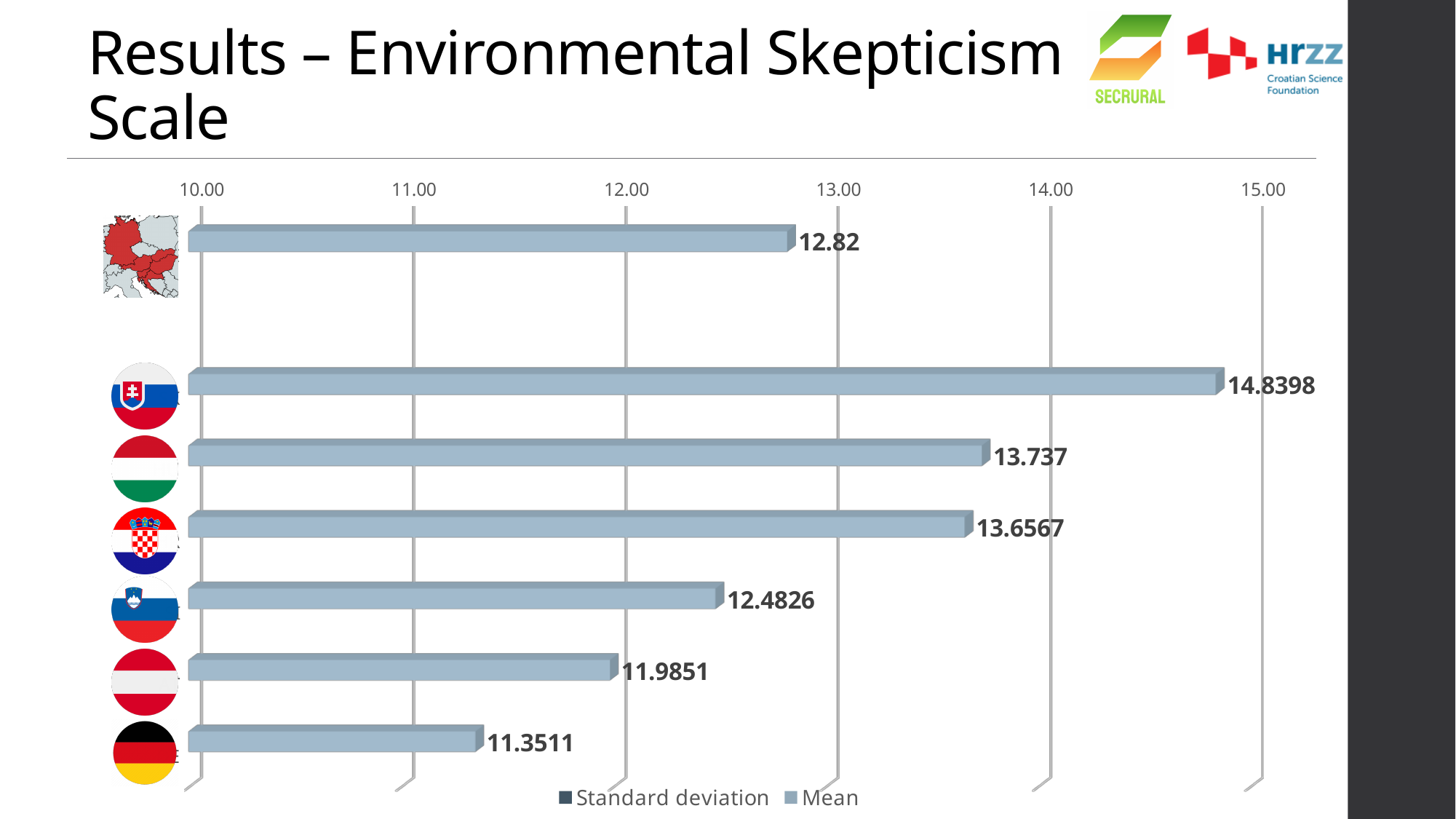
What is the value of the bar labelled with the Austrian flag? 11.9851 What is the value of the longest bar in the chart? 14.8398 What are the two series named in the legend? Standard deviation and Mean What is the difference between the longest bar (14.8398) and the shortest bar (11.3511)? 3.4887 Is the value of the topmost bar greater or less than 13.00? less How many series does the legend list? 2 What is the value of the topmost bar (the one labelled with the regional map)? 12.82 What is the value of the shortest bar in the chart (the bottom bar)? 11.3511 How many bars are plotted in the chart? 7 Which is larger: the bar labelled with the Hungarian flag (13.737) or the bar labelled with the Slovenian flag (12.4826)? Hungarian flag (13.737) What is the value of the bar labelled with the Croatian flag? 13.6567 What type of chart is shown on the slide? bar chart